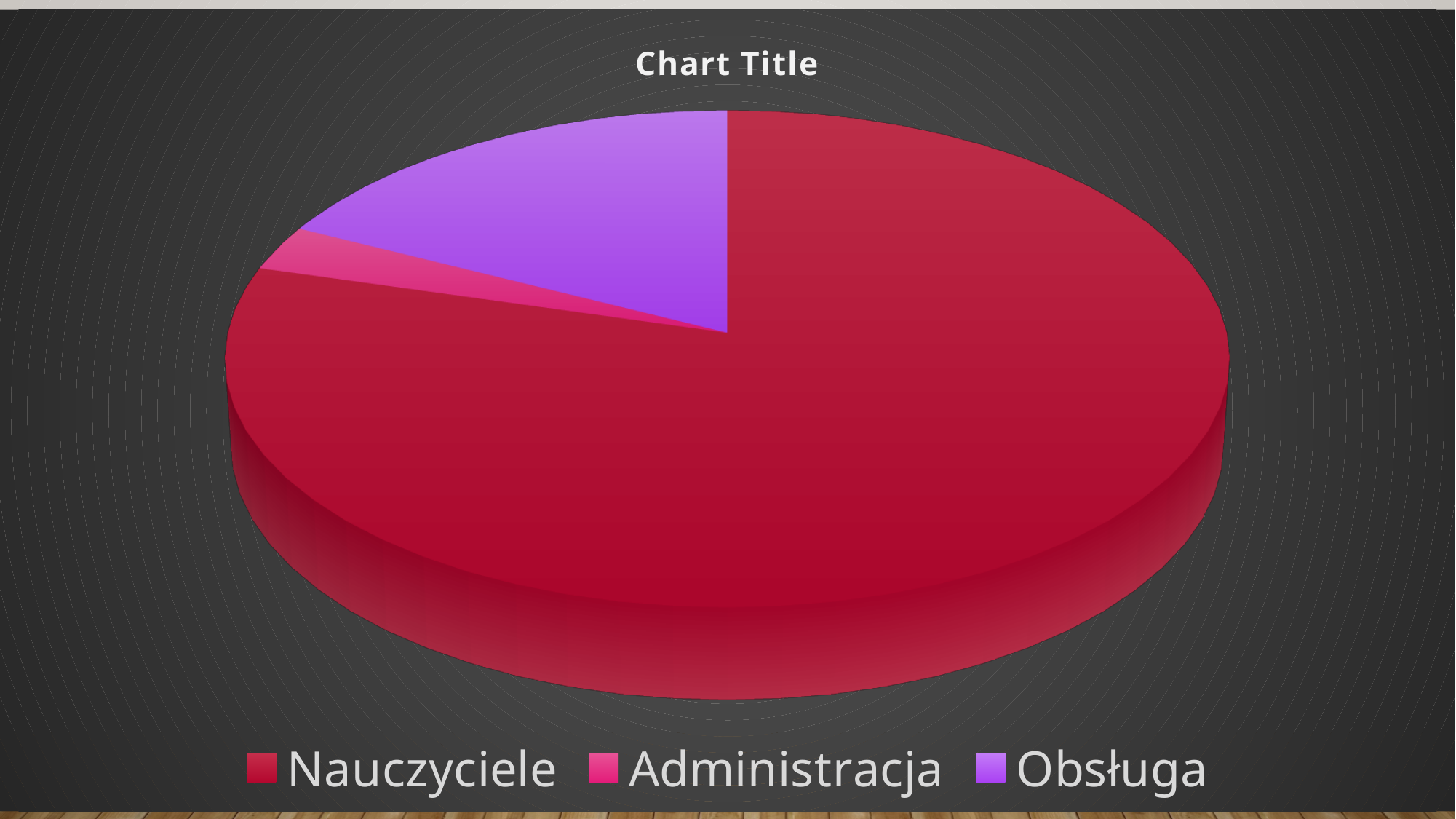
Which category has the largest slice of the pie? Nauczyciele What colour is the Obsługa slice in the pie chart? purple What kind of chart is shown on the slide? pie chart Which category has the smallest slice of the pie? Administracja How many entries does the legend list? 3 What is the title of the chart? Chart Title Which slice is larger, Nauczyciele or Obsługa? Nauczyciele How many slices does the pie chart have? 3 Which slice is larger, Obsługa or Administracja? Obsługa